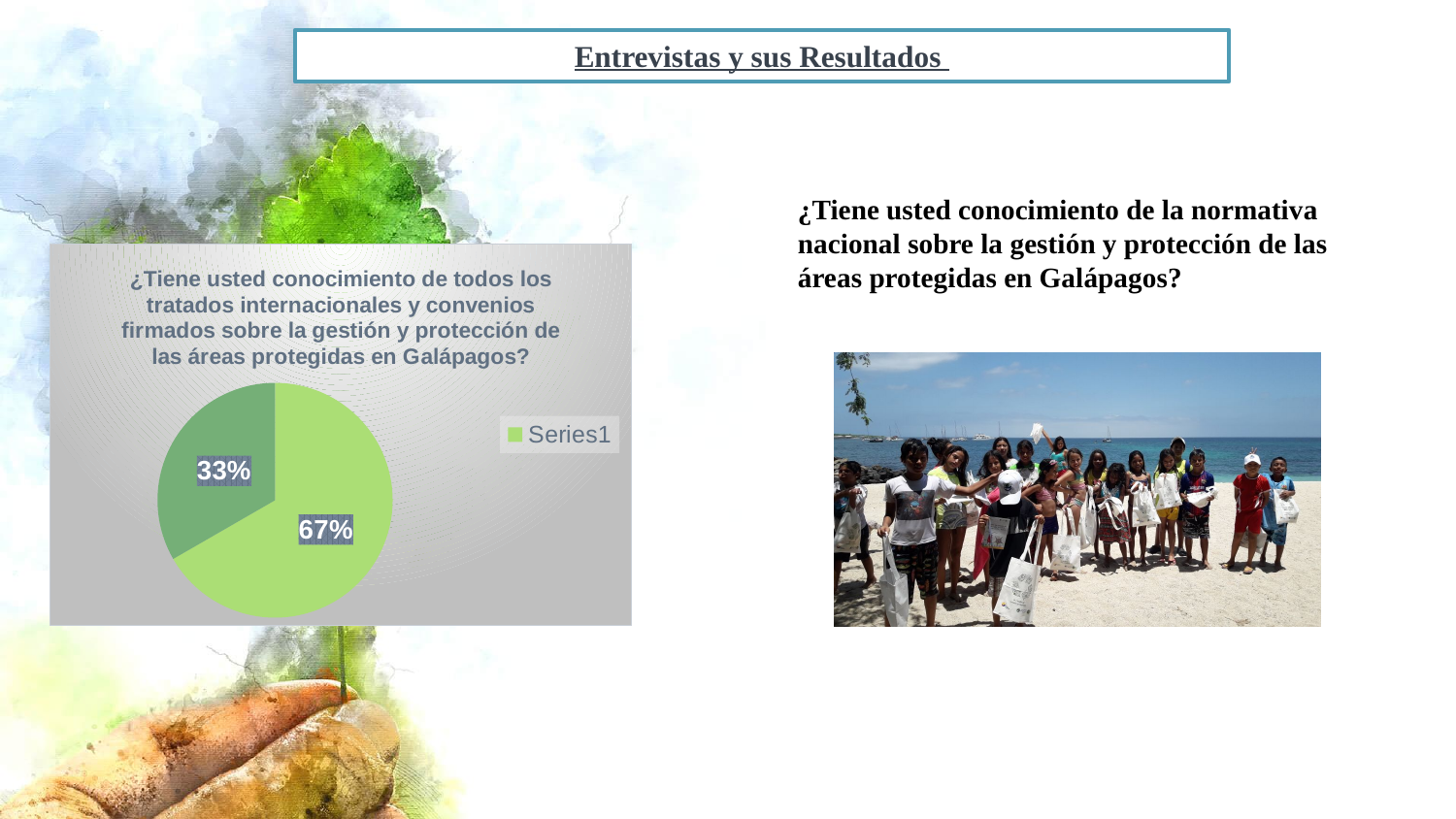
How many series does the legend of the pie chart list? 1 What is the title of the pie chart? ¿Tiene usted conocimiento de todos los tratados internacionales y convenios firmados sobre la gestión y protección de las áreas protegidas en Galápagos? What percentage is shown on the dark green slice of the pie chart? 33% Which slice of the pie chart is larger, the light green one or the dark green one? the light green one What is the value shown on the larger slice of the pie chart? 67% What is the value shown on the smaller slice of the pie chart? 33% How many slices does the pie chart have? 2 What is the total of the two slice values shown in the pie chart? 100% What percentage is shown on the light green slice of the pie chart? 67% What is the legend entry shown next to the pie chart? Series1 What is the difference between the two slice values in the pie chart? 34% What kind of chart is shown on the slide? pie chart